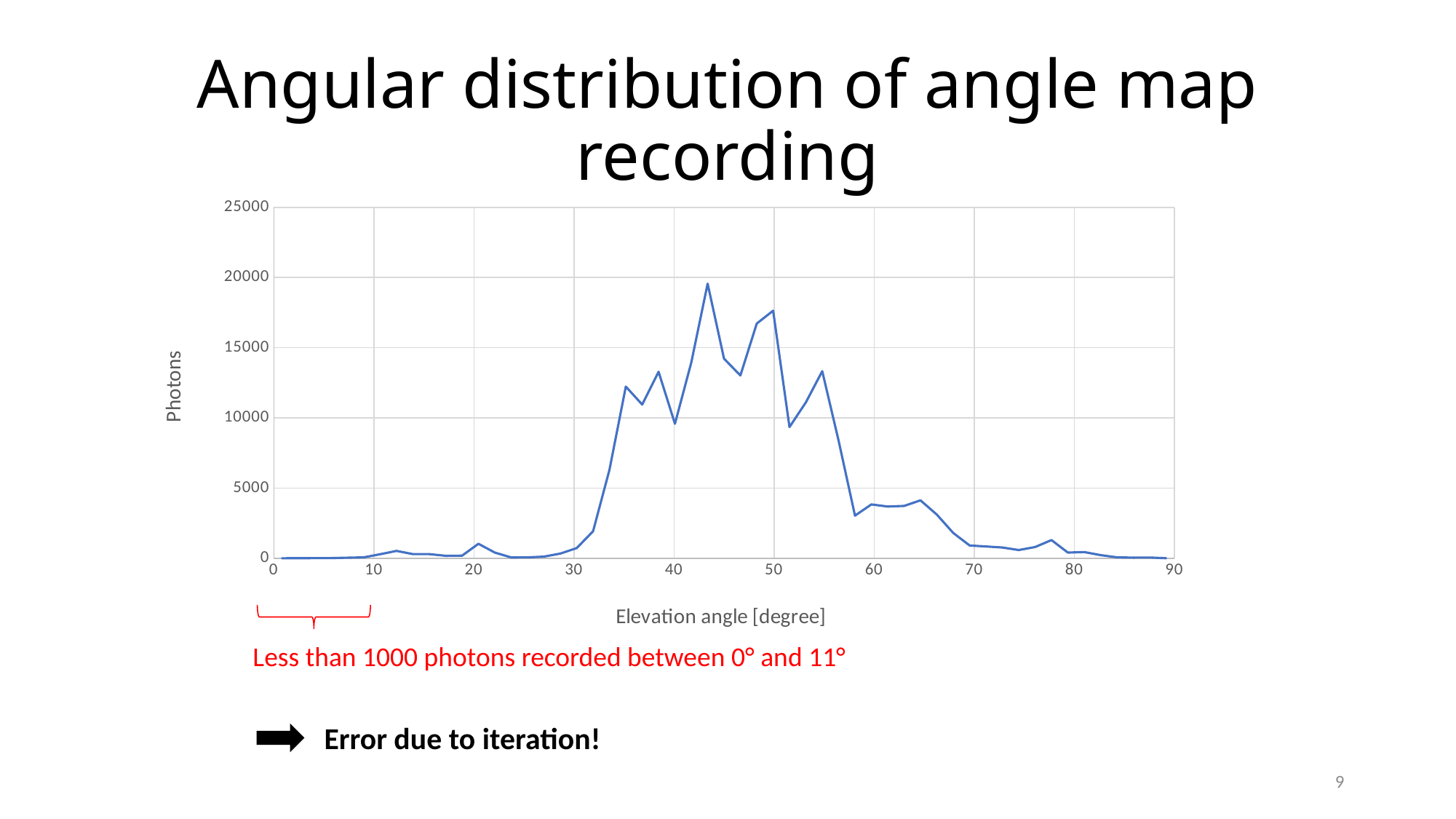
What is the label of the y axis of the chart? Photons Is the value at an elevation angle of 60 degrees greater or less than 5000 photons? less Is the value at an elevation angle of 80 degrees greater or less than 5000 photons? less What kind of chart is shown on the slide? line chart Do the values generally rise or fall as the elevation angle goes from 30 to 43 degrees? rise Do the values generally rise or fall as the elevation angle goes from 60 to 90 degrees? fall Is the value at an elevation angle of 20 degrees greater or less than 5000 photons? less What is the label of the x axis of the chart? Elevation angle [degree] Is the value at an elevation angle of 50 degrees larger or smaller than the value at 70 degrees? larger